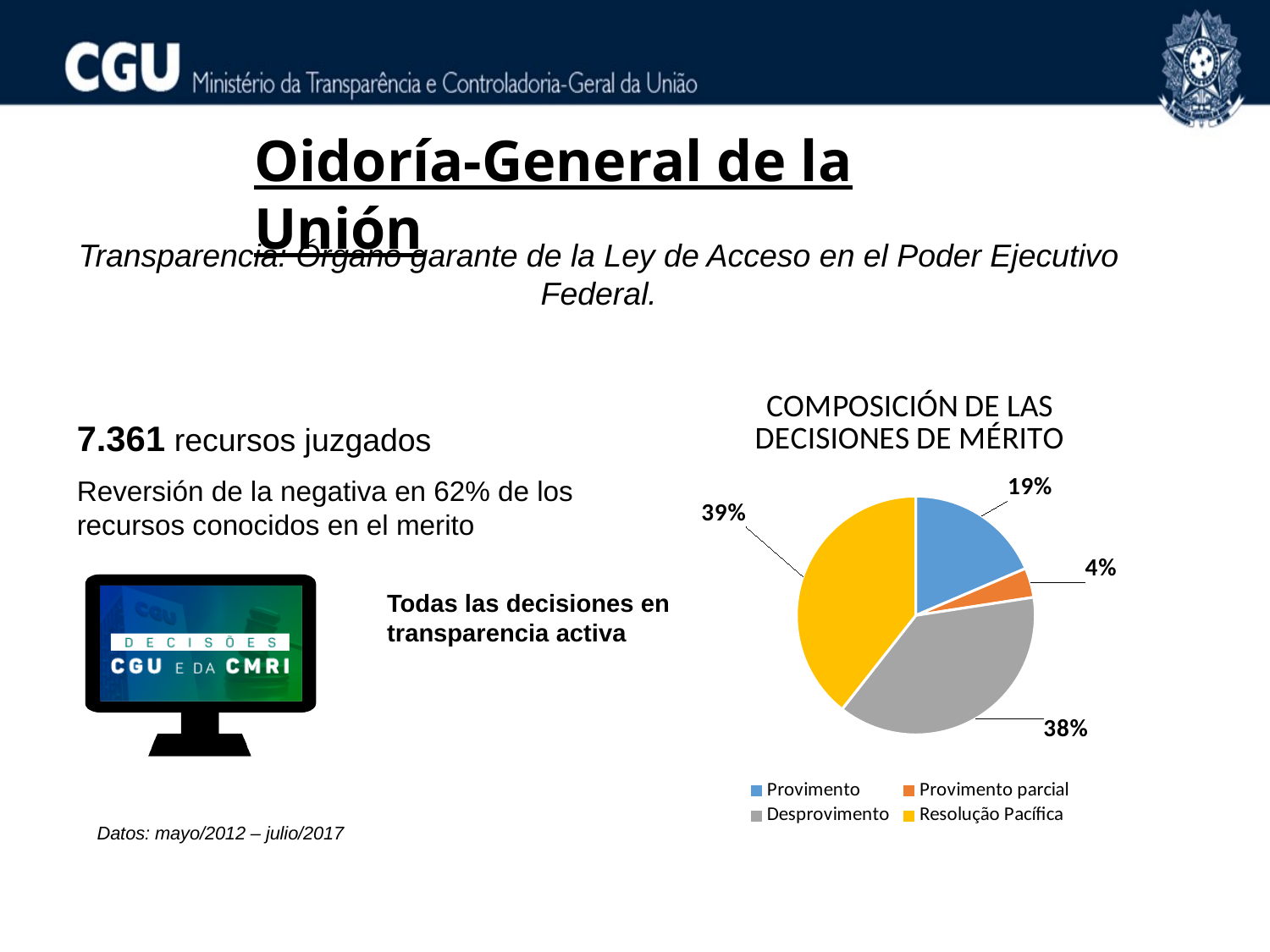
What colour is the Resolução Pacífica slice? yellow How many slices does the pie chart have? 4 What share of the pie is Desprovimento? 38% What kind of chart is shown on the slide? pie chart What is the difference in percentage points between Desprovimento and Provimento? 19 Which is larger, the share for Provimento or the share for Desprovimento? Desprovimento Which category has the smallest slice of the pie? Provimento parcial What is the title of the chart? COMPOSICIÓN DE LAS DECISIONES DE MÉRITO What share of the pie is Provimento? 19% What share of the pie is Provimento parcial? 4% How many entries does the legend list? 4 What share of the pie is Resolução Pacífica? 39%